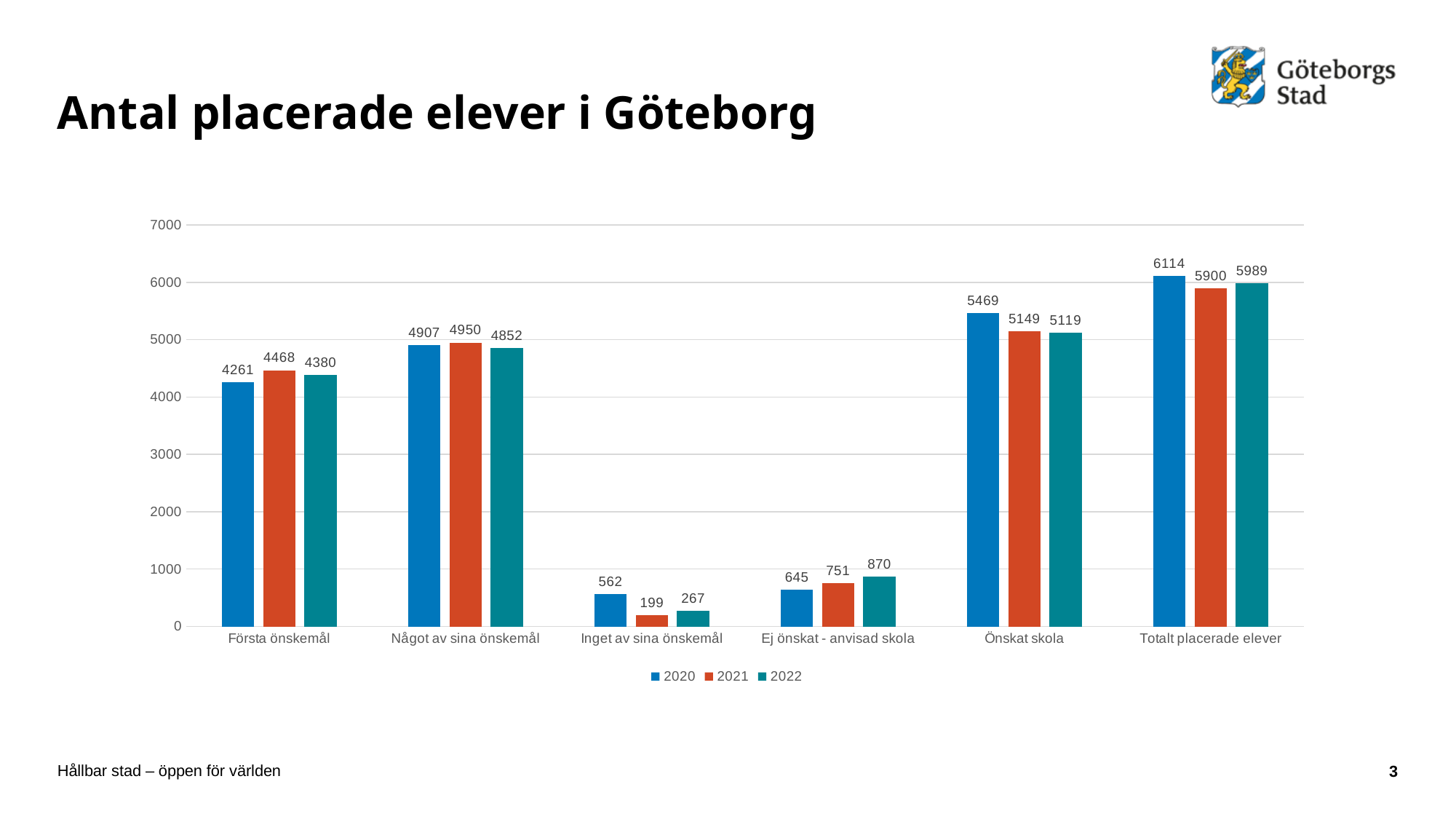
How many categories are shown on the x axis? 6 What is the difference between the 2022 and 2020 values for 'Ej önskat - anvisad skola'? 225 Which category has the lowest value for the 2020 series? Inget av sina önskemål Which category has the highest value for the 2021 series? Totalt placerade elever What is the value for 2021 in the 'Inget av sina önskemål' category? 199 Which series is shown in orange in the legend? 2021 What kind of chart is shown on the slide? bar chart Which is larger for 'Önskat skola': the 2020 value or the 2022 value? 2020 How many series does the legend list? 3 What is the value for 2022 in the 'Första önskemål' category? 4380 What is the value for 2020 in the 'Totalt placerade elever' category? 6114 Is the 2021 value for 'Något av sina önskemål' greater or less than 4000? greater